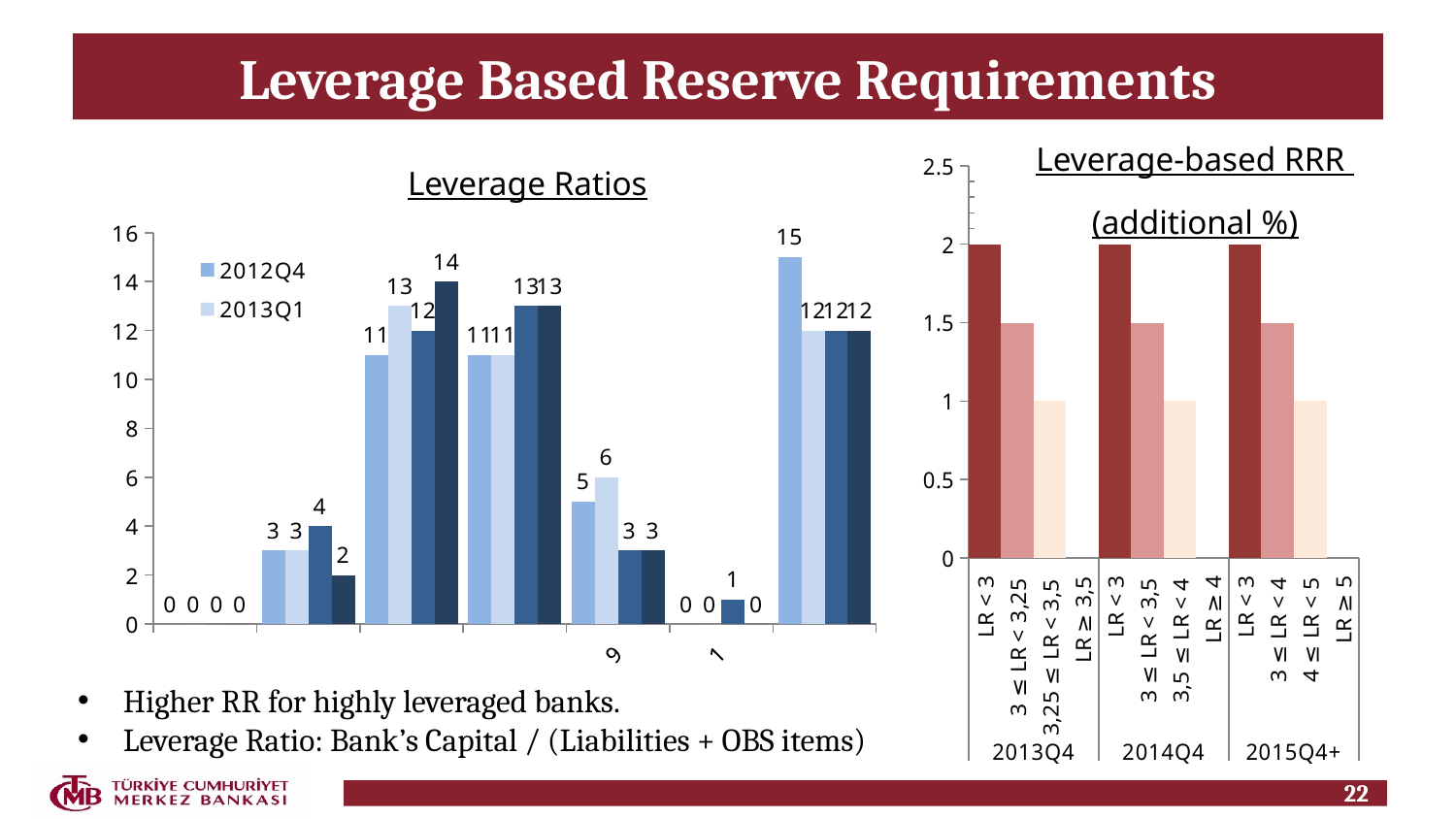
On the Leverage-based RRR (additional %) chart, what is the value for 3,25 ≤ LR < 3,5 in 2013Q4? 1 How many period groups (2013Q4, 2014Q4, 2015Q4+) are shown on the Leverage-based RRR (additional %) chart? 3 On the Leverage-based RRR (additional %) chart, what is the difference between LR < 3 and 3,25 ≤ LR < 3,5 in 2013Q4? 1 On the Leverage-based RRR (additional %) chart, what is the value for 4 ≤ LR < 5 in 2015Q4+? 1 What kind of chart is the Leverage Ratios chart on the left? bar chart On the Leverage-based RRR (additional %) chart, what is the value for 3 ≤ LR < 3,25 in 2013Q4? 1.5 On the Leverage-based RRR (additional %) chart, do the values rise or fall from LR < 3 to 3,5 ≤ LR < 4 within the 2014Q4 group? fall What is the title of the chart on the left of the slide? Leverage Ratios On the Leverage-based RRR (additional %) chart, which is larger in 2014Q4: LR < 3 or 3,5 ≤ LR < 4? LR < 3 On the Leverage-based RRR (additional %) chart, what is the value for 3 ≤ LR < 4 in 2015Q4+? 1.5 What is the highest value labelled on the Leverage Ratios chart? 15 On the Leverage-based RRR (additional %) chart, what is the value for LR < 3 in 2013Q4? 2